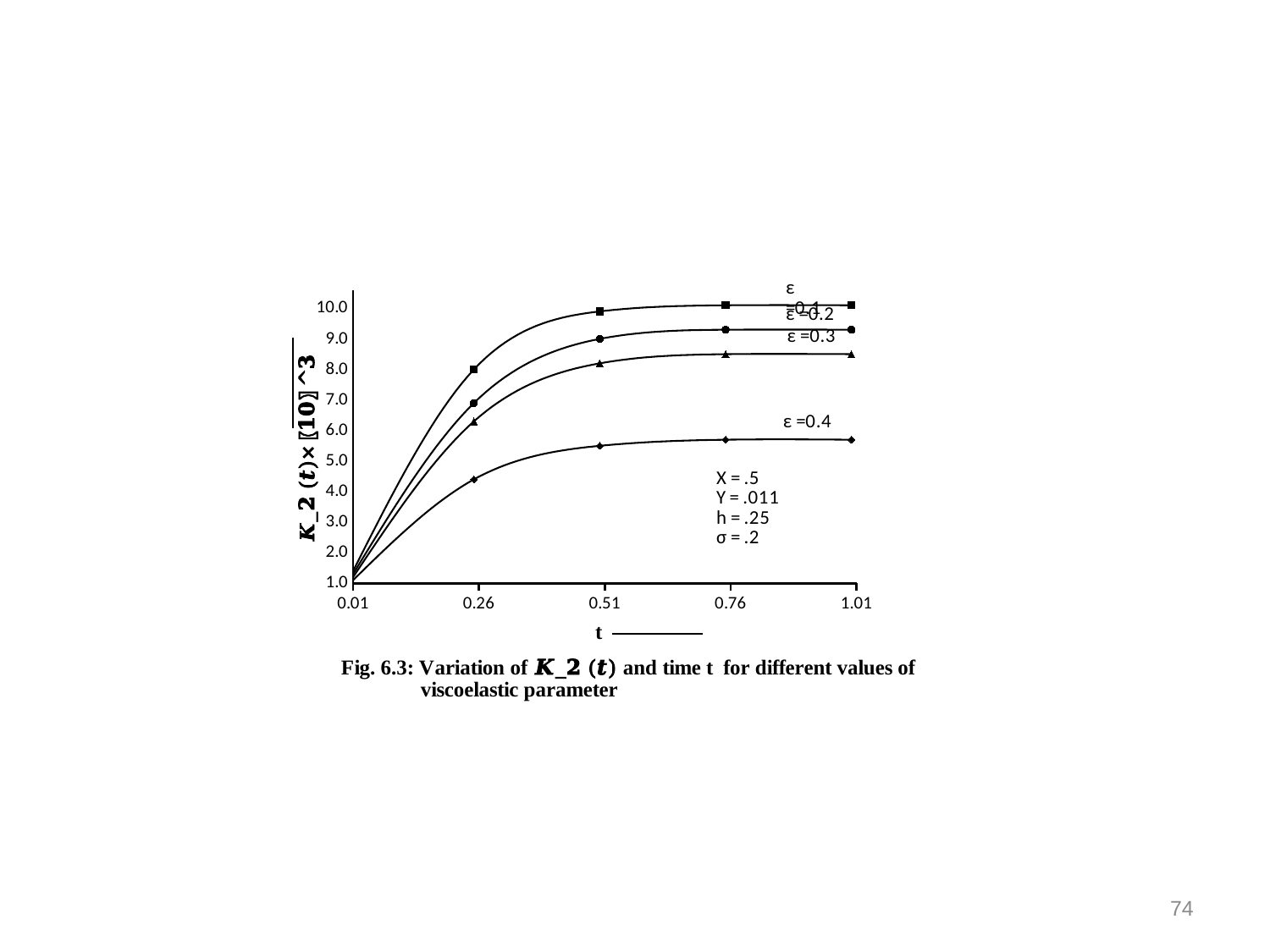
Is the value of the ε =0.4 curve at t = 1.01 greater or less than 6.0? less Is the value of the ε =0.3 curve at t = 1.01 greater or less than 8.0? greater Is the value of the ε =0.1 curve at t = 0.51 greater or less than 9.0? greater What figure number is given in the caption below the chart? Fig. 6.3 What value of σ is stated in the annotation on the chart? .2 Which curve has the highest value at t = 1.01? ε =0.1 Which curve has the lowest value at t = 1.01? ε =0.4 What kind of chart is shown on the slide? line chart Do the curves rise or fall as t increases from 0.01 to 0.51? rise How many tick labels are shown on the t axis? 5 At t = 0.51, which curve is higher: ε =0.1 or ε =0.4? ε =0.1 How many curves (values of ε) are plotted on the chart? 4